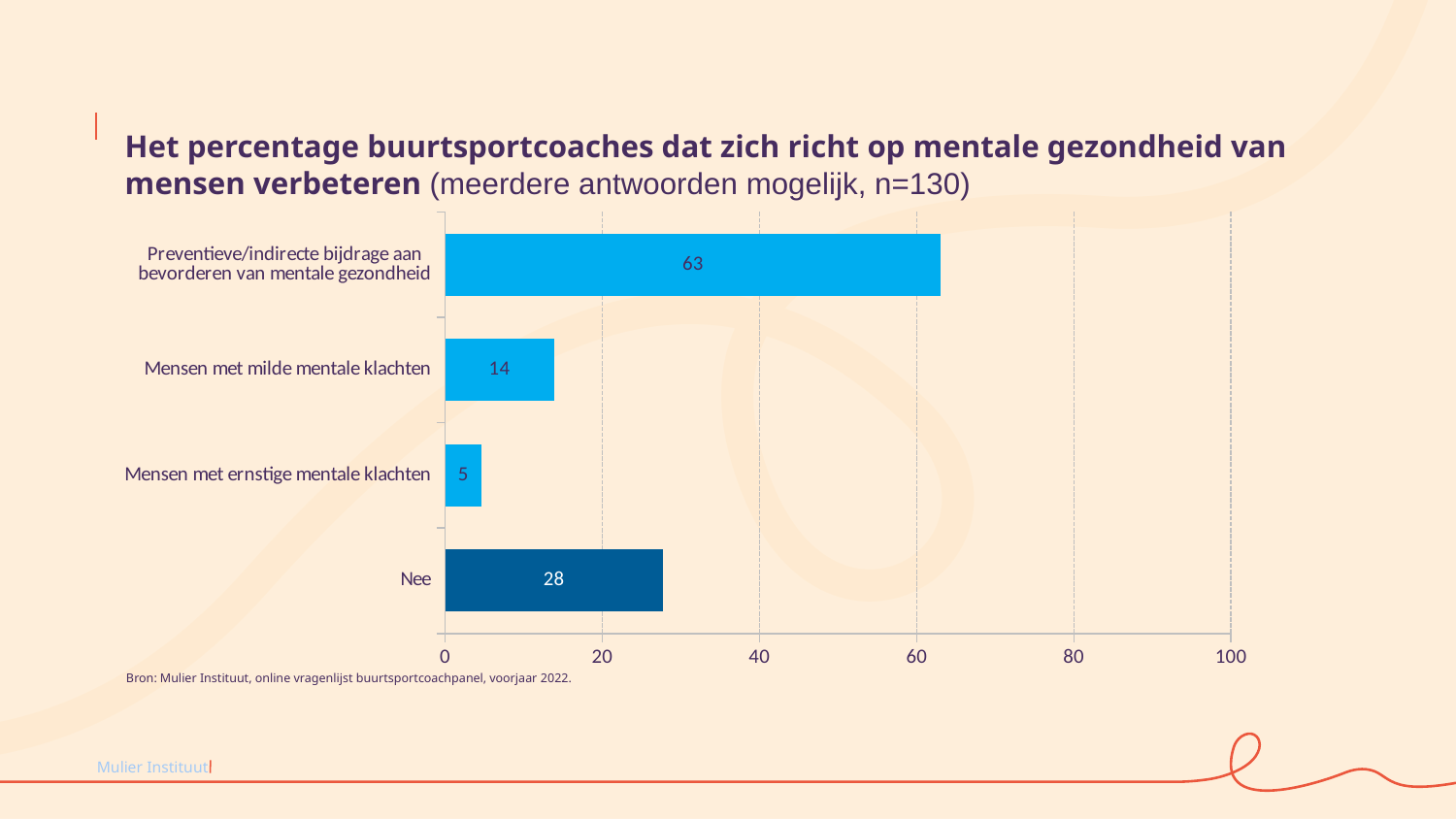
What is the value for 'Preventieve/indirecte bijdrage aan bevorderen van mentale gezondheid'? 63 What is the value for 'Mensen met milde mentale klachten'? 14 What is the value for 'Mensen met ernstige mentale klachten'? 5 What is the maximum value shown on the horizontal axis? 100 What is the value for 'Nee'? 28 What kind of chart is shown on the slide? Bar chart Which is larger: the value for 'Nee' or the value for 'Mensen met milde mentale klachten'? Nee What is the difference between the values for 'Nee' and 'Mensen met milde mentale klachten'? 14 Which category has the lowest value? Mensen met ernstige mentale klachten Which category has the highest value? Preventieve/indirecte bijdrage aan bevorderen van mentale gezondheid What is the difference between the values for 'Preventieve/indirecte bijdrage aan bevorderen van mentale gezondheid' and 'Nee'? 35 How many categories are shown in the chart? 4